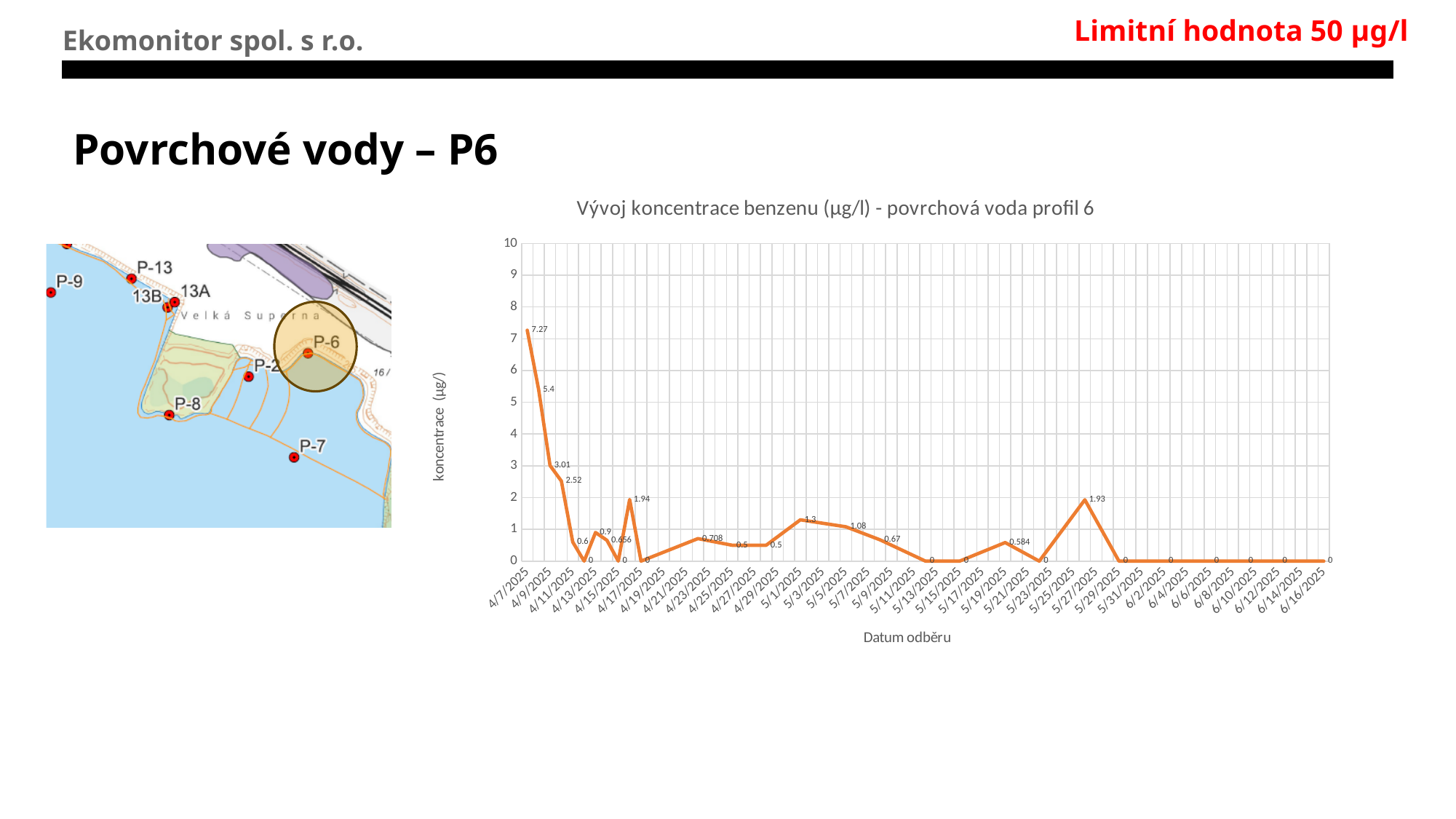
On which date does the chart show its highest value? 4/7/2025 What kind of chart is shown on the slide? line chart Which is larger: the peak labelled 1.94 in April or the peak labelled 1.93 in late May? 1.94 What is the concentration value plotted for 4/7/2025? 7.27 What is the title of the chart? Vývoj koncentrace benzenu (µg/l) - povrchová voda profil 6 What is the concentration value plotted for 6/16/2025? 0 What is the highest benzene concentration value plotted on the chart? 7.27 What is the difference between the first plotted value (7.27) and the second plotted value (5.4)? 1.87 What is the label of the x axis of the chart? Datum odběru What is the maximum value shown on the y axis of the chart? 10 Overall, do the plotted values rise or fall from the start to the end of the x axis? fall Is the value for 4/7/2025 greater or less than 5? greater